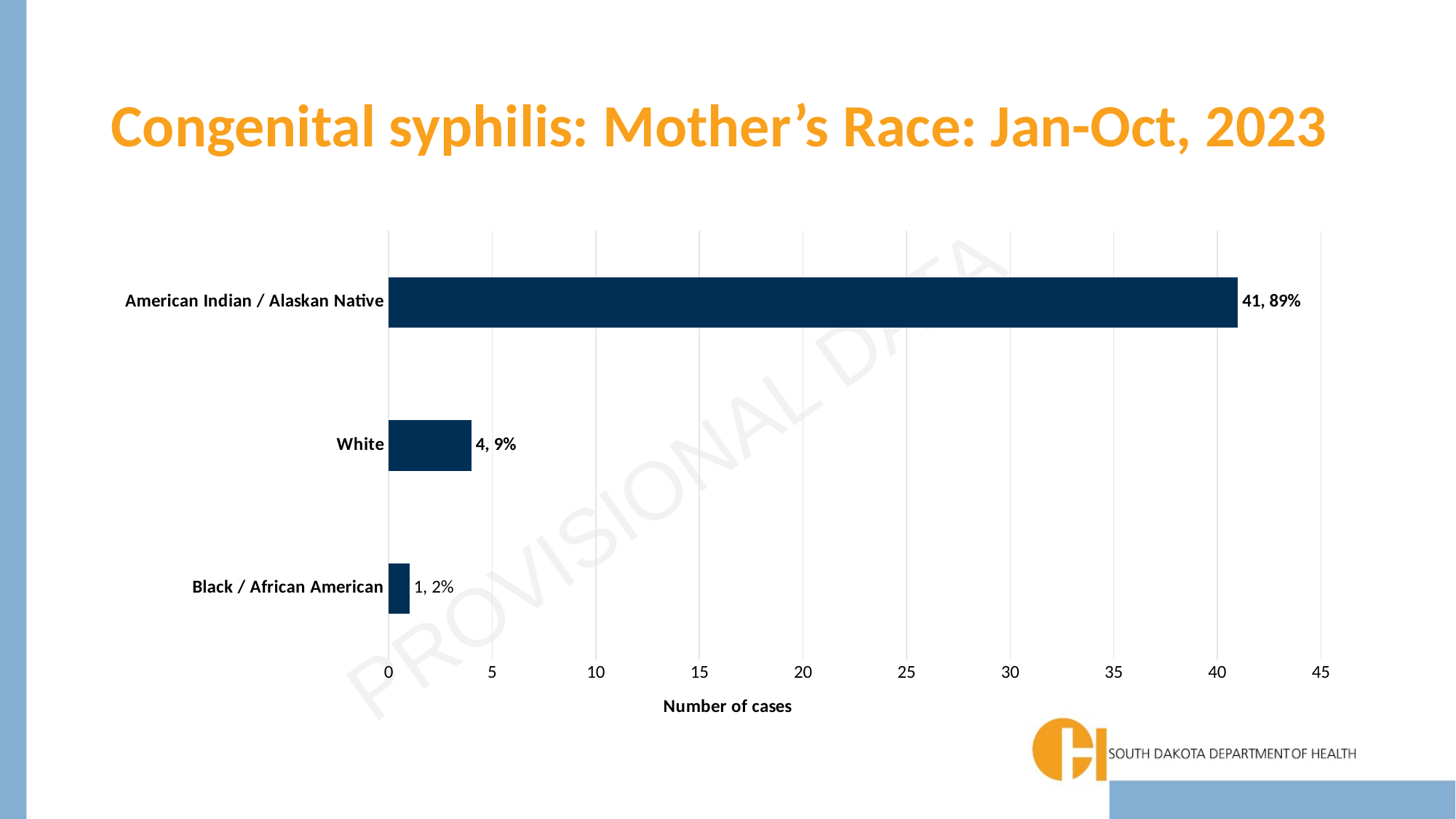
What percentage of cases had a mother of American Indian / Alaskan Native race? 89% Which race category has the lowest number of cases? Black / African American How many race categories are shown in the chart? 3 Which race category has the highest number of cases? American Indian / Alaskan Native Which has more cases, White or Black / African American? White What percentage of cases is shown for White mothers? 9% What kind of chart is shown on the slide? Bar chart How many cases are shown for White mothers? 4 What is the label of the horizontal axis? Number of cases How many cases are shown for Black / African American mothers? 1 How many congenital syphilis cases had a mother of American Indian / Alaskan Native race? 41 What is the difference in number of cases between American Indian / Alaskan Native and White mothers? 37